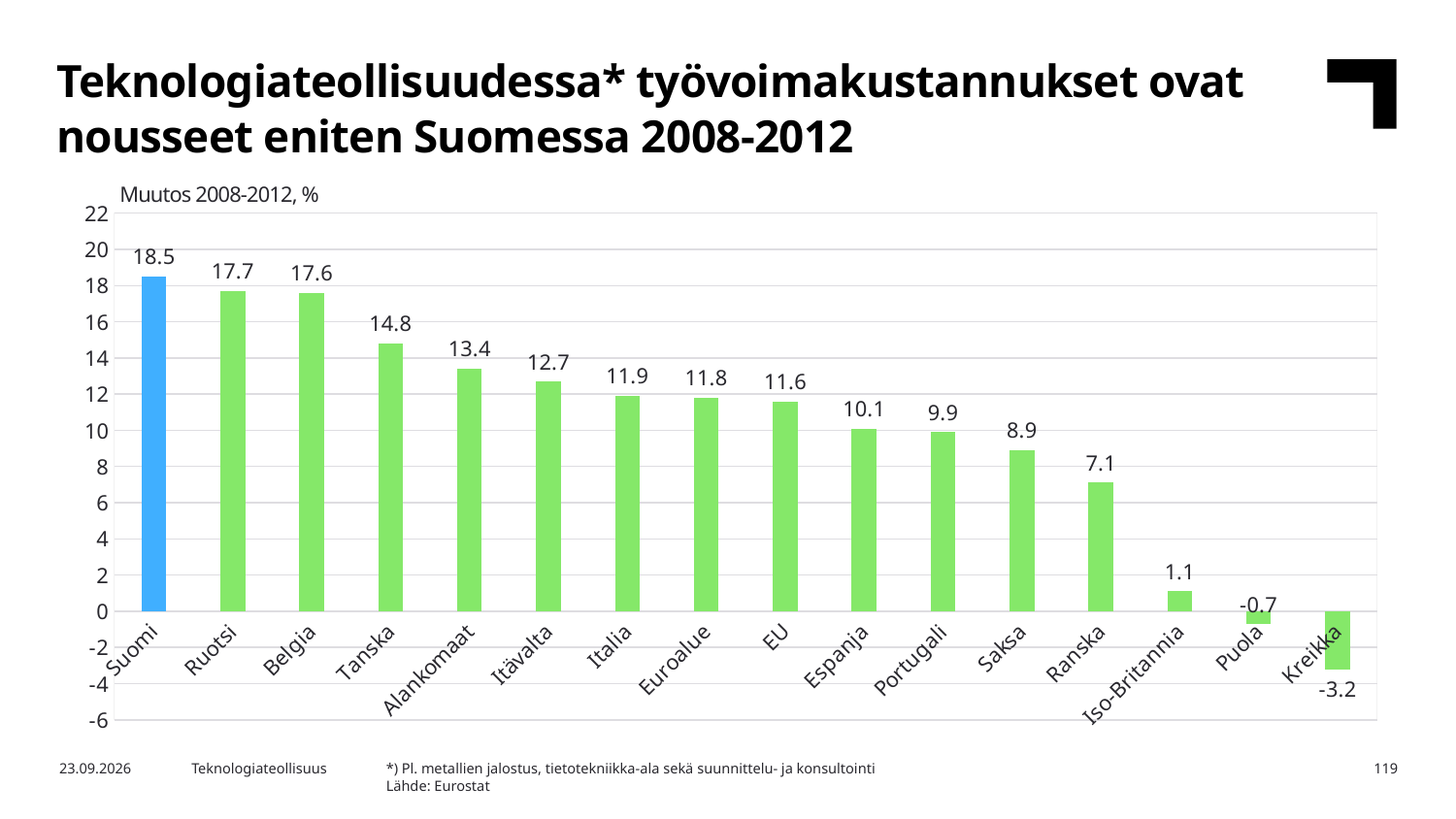
What is the value for Euroalue? 11.8 What is the difference between the values for Suomi and Saksa? 9.6 What is the label shown above the chart's y axis? Muutos 2008-2012, % Which has a larger value, Tanska or Espanja? Tanska What is the value for Suomi? 18.5 Which country has the lowest value? Kreikka Which country has the highest value? Suomi What is the value for Alankomaat? 13.4 What is the value for Kreikka? -3.2 What kind of chart is shown on the slide? Bar chart Do the values rise or fall from left to right along the x axis? Fall How many countries or regions are shown on the x axis? 16